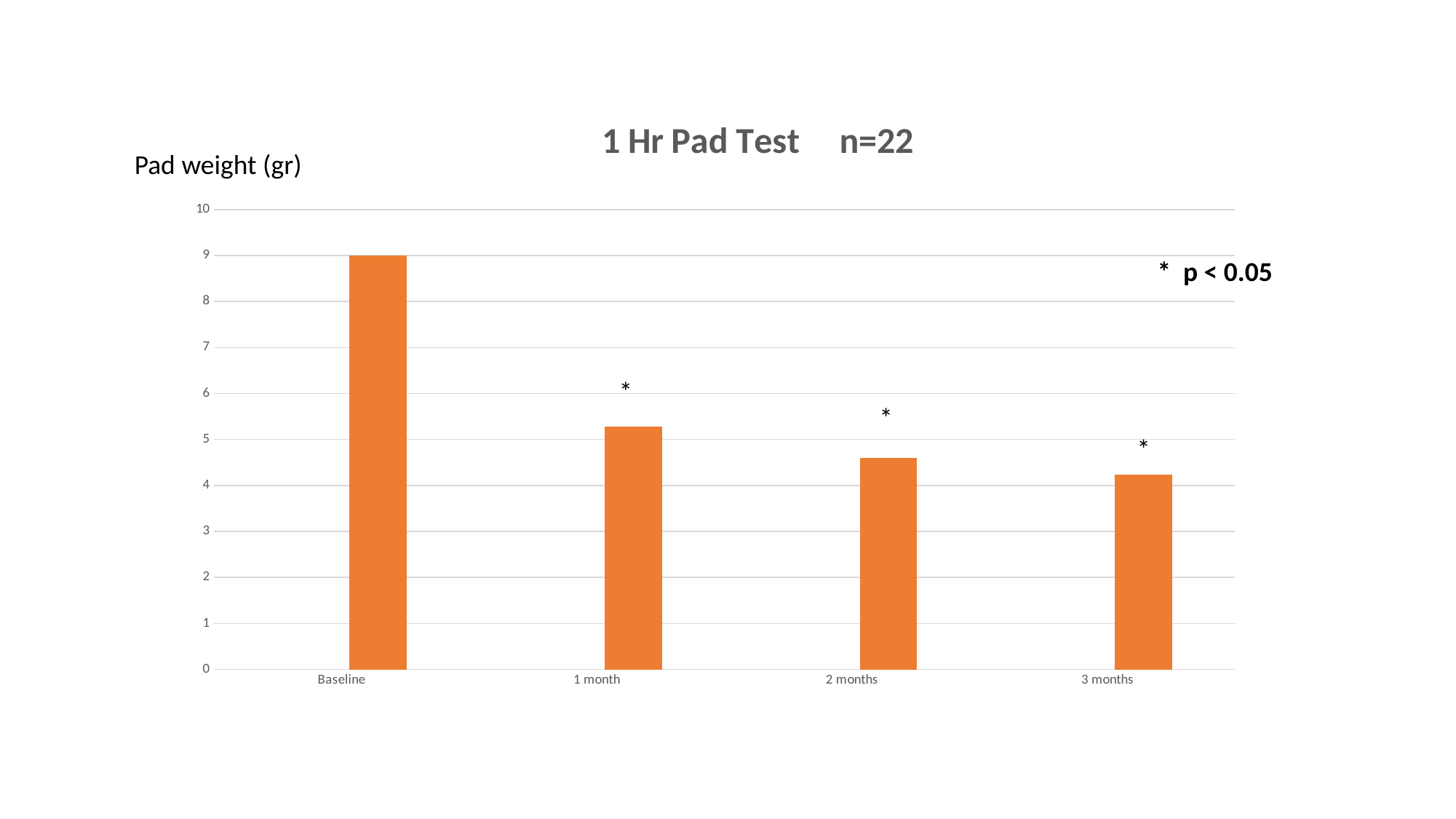
Which is larger, the value for 1 month or the value for 2 months? 1 month What is the label of the vertical axis? Pad weight (gr) Which category has the highest pad weight? Baseline What is the pad weight value for Baseline? 9 How many categories are shown on the x axis of the chart? 4 What is the title of the chart? 1 Hr Pad Test n=22 Do the pad weight values rise or fall from Baseline to 3 months? fall Which category has the lowest pad weight? 3 months Is the value for 2 months greater or less than 5? less Is the value for 3 months greater or less than 4? greater What type of chart is shown on the slide? bar chart Is the value for 1 month greater or less than 5? greater